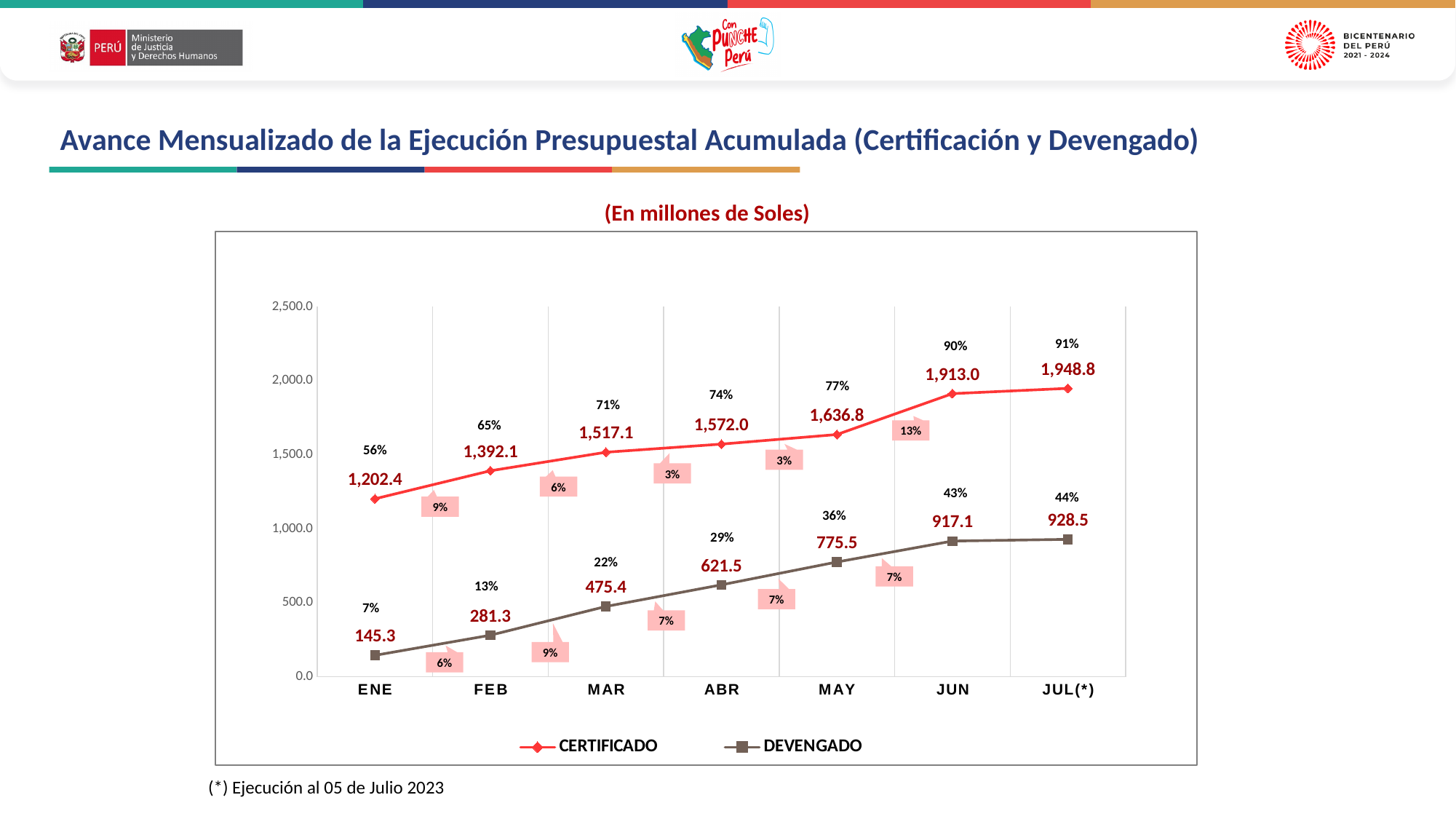
In which month is the DEVENGADO value lowest? ENE How many months are shown on the x axis? 7 How many series does the legend list? 2 What percentage is shown above the CERTIFICADO value for JUN? 90% What is the DEVENGADO value for MAY? 775.5 Does the DEVENGADO series rise or fall from ENE to JUL(*)? rise What is the difference between the DEVENGADO values for FEB and MAR? 194.1 In which month is the CERTIFICADO value highest? JUL(*) Which is larger, the CERTIFICADO value for MAR or the CERTIFICADO value for MAY? MAY What is the DEVENGADO value for JUL(*)? 928.5 What is the CERTIFICADO value for ENE? 1,202.4 What is the difference between the CERTIFICADO and DEVENGADO values in ABR? 950.5